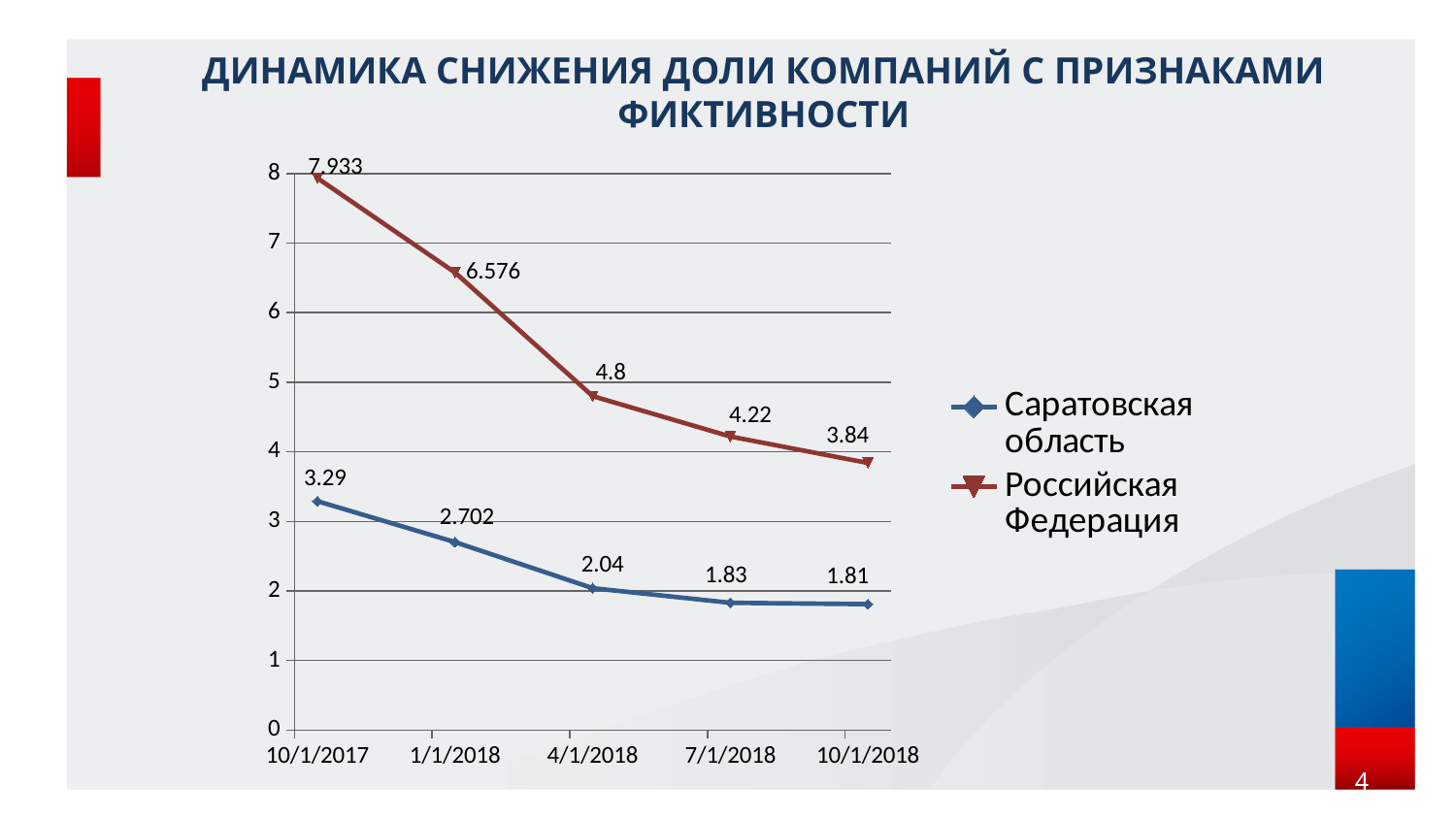
Which series has the larger value at 4/1/2018, Саратовская область or Российская Федерация? Российская Федерация Do the values for Российская Федерация rise or fall from 10/1/2017 to 10/1/2018? fall How many dates are plotted along the x axis? 5 At which date is the value for Российская Федерация lowest? 10/1/2018 What is the difference between the Российская Федерация and Саратовская область values at 7/1/2018? 2.39 At which date is the value for Саратовская область highest? 10/1/2017 What is the value for Саратовская область at 1/1/2018? 2.702 What is the value for Российская Федерация at 10/1/2017? 7.933 How many series does the legend list? 2 What is the value for Саратовская область at 10/1/2018? 1.81 What type of chart is shown on the slide? line chart What is the value for Российская Федерация at 4/1/2018? 4.8